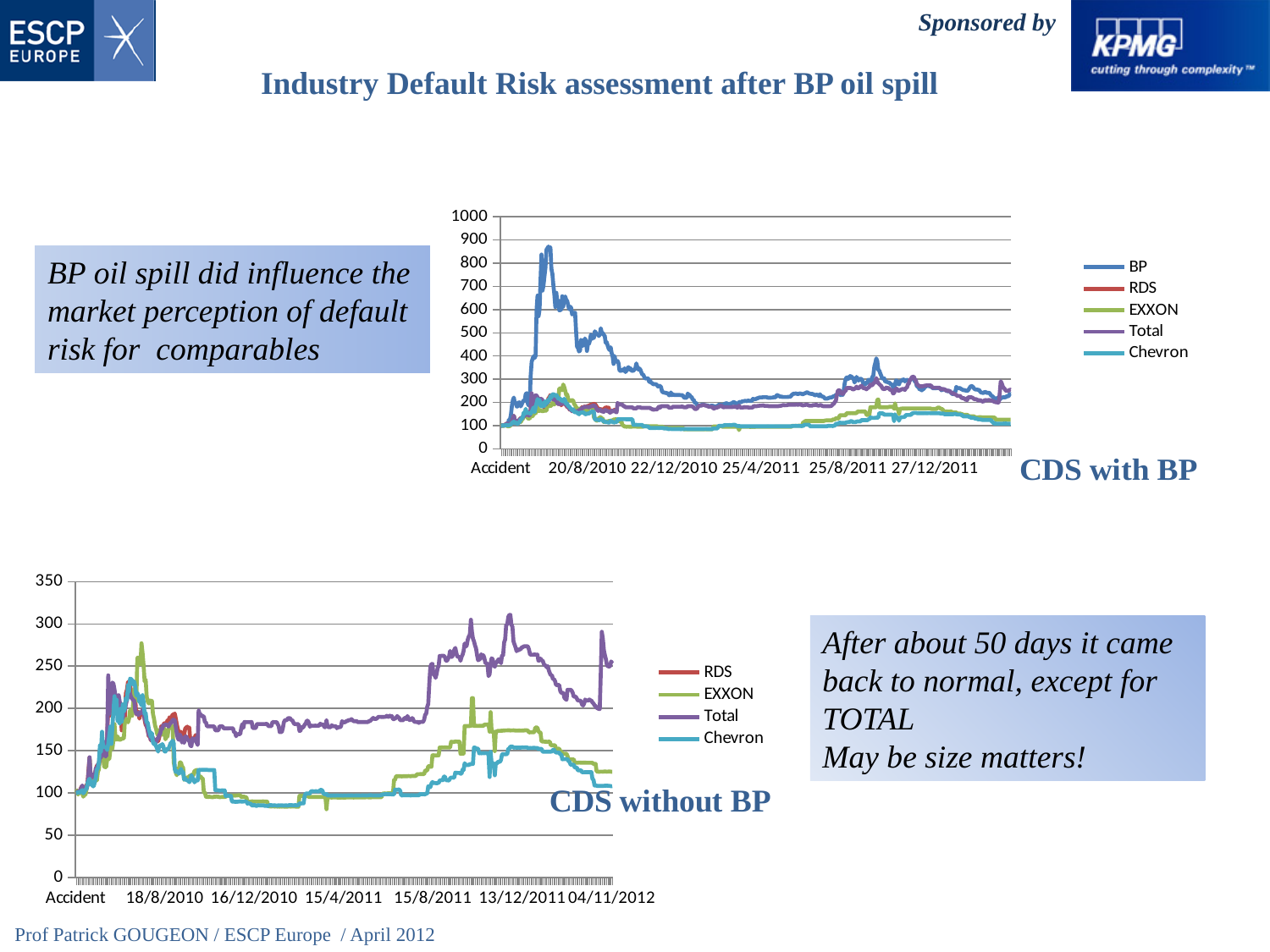
What is the first label on the x axis of the 'CDS without BP' chart? Accident What kind of chart is the 'CDS with BP' chart? line chart How many series does the legend of the 'CDS without BP' chart list? 4 In the 'CDS without BP' chart, is the peak value of Total greater or less than 250? greater In the 'CDS without BP' chart, is the value of Chevron at the last date greater or less than 150? less In the 'CDS with BP' chart, is the peak value of BP greater or less than 800? greater In the 'CDS with BP' chart, which series reaches the highest value? BP What is the highest value shown on the y axis of the 'CDS without BP' chart? 350 How many date labels are shown on the x axis of the 'CDS without BP' chart? 6 In the 'CDS with BP' chart, is the peak value of BP greater or less than the peak value of Total? greater How many series does the legend of the 'CDS with BP' chart list? 5 In the 'CDS without BP' chart, which series reaches the highest value? Total